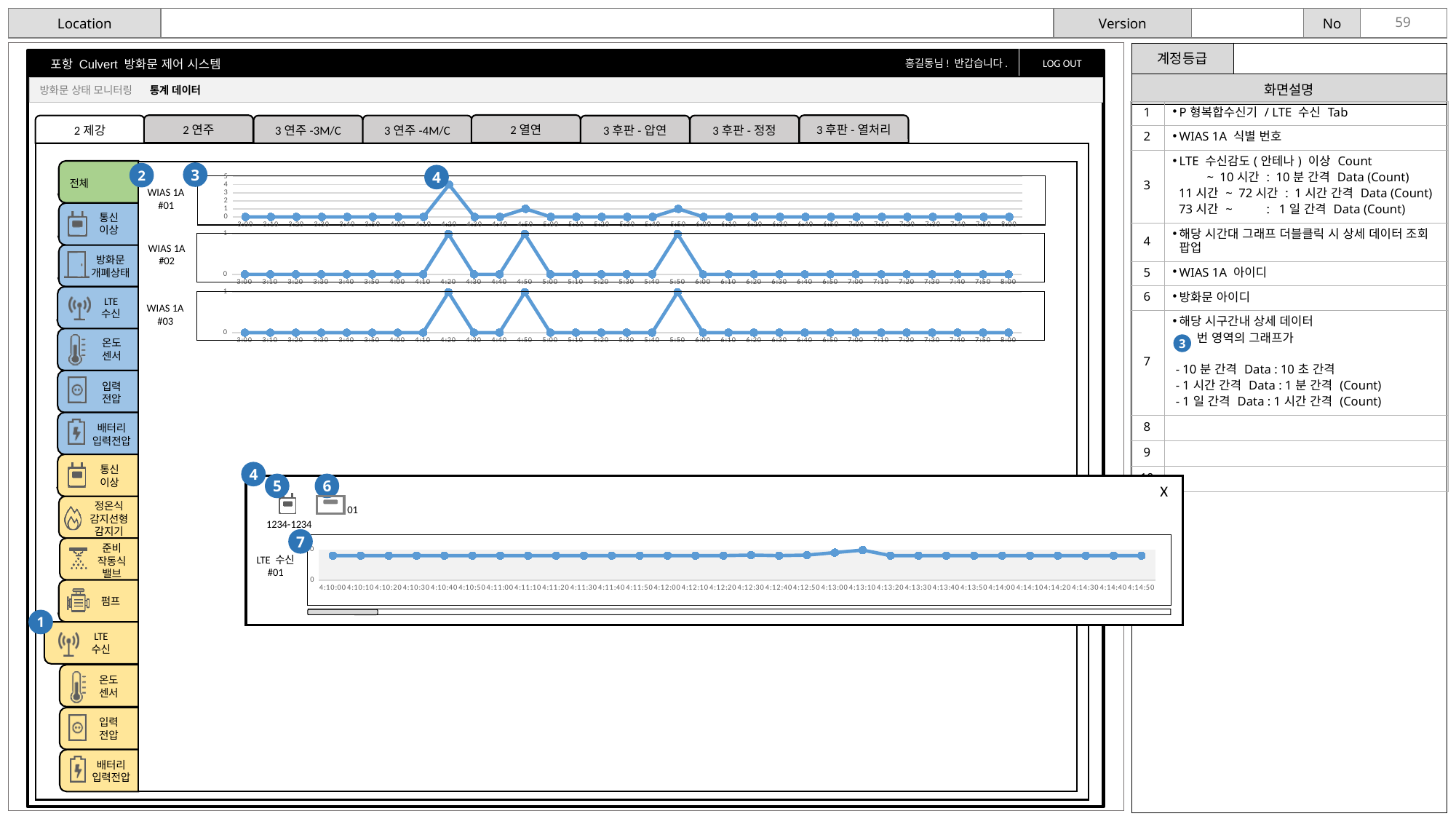
In the WIAS 1A #01 chart, which time has the higher value, 4:20 or 4:50? 4:20 In the WIAS 1A #01 chart, at which time does the line reach its highest point? 4:20 In the WIAS 1A #03 chart, which time has the higher value, 5:50 or 6:00? 5:50 In the popup chart labelled LTE 수신 #01, at which time does the line reach its highest point? 4:13:10 What is the first time label on the x axis of the WIAS 1A #02 chart? 3:00 In the WIAS 1A #03 chart, what is the value at 3:00? 0 In the WIAS 1A #02 chart, what is the value at 4:20? 1 In the WIAS 1A #02 chart, how many times does the line rise to 1? 3 What kind of chart is used for the WIAS 1A #01, #02 and #03 panels? line chart How many WIAS 1A line charts are shown in the main statistics area (excluding the popup)? 3 In the WIAS 1A #01 chart, is the value at 4:20 greater or less than 3? greater In the WIAS 1A #01 chart, is the value at 4:50 greater or less than 3? less